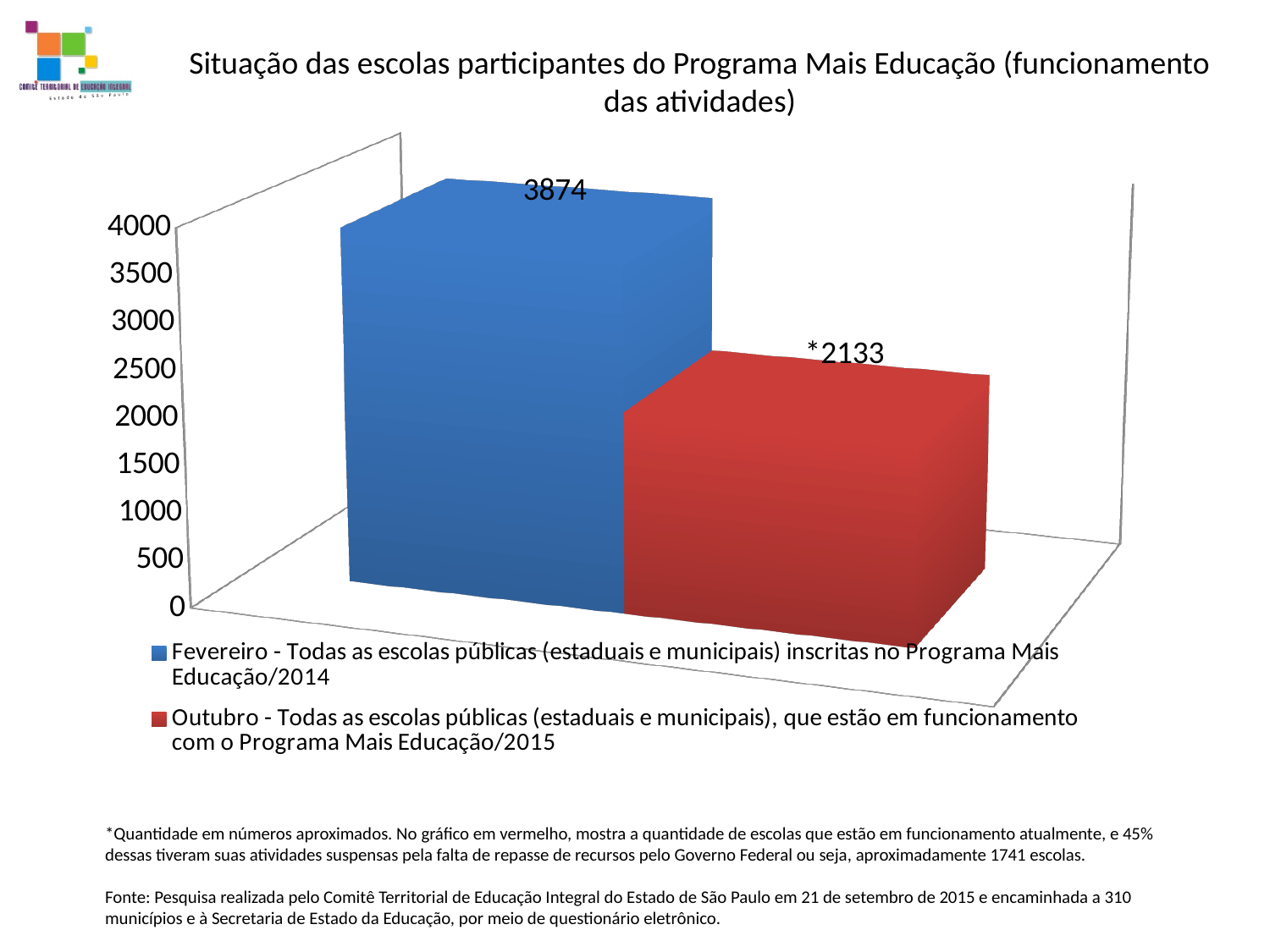
What colour is the bar for the Outubro series? red Is the Fevereiro value larger or smaller than the Outubro value? larger Is the value for Fevereiro greater or less than 3500? greater How many series does the legend list? 2 Which series has the highest value, Fevereiro or Outubro? Fevereiro How many bars are plotted in the chart? 2 What is the difference between the Fevereiro value and the Outubro value? 1741 Is the value for Outubro greater or less than 2500? less What kind of chart is shown on the slide? bar chart Which series has the lowest value in the chart? Outubro What value is shown for the Fevereiro bar (escolas inscritas no Programa Mais Educação/2014)? 3874 What value is shown for the Outubro bar (escolas em funcionamento com o Programa Mais Educação/2015)? 2133